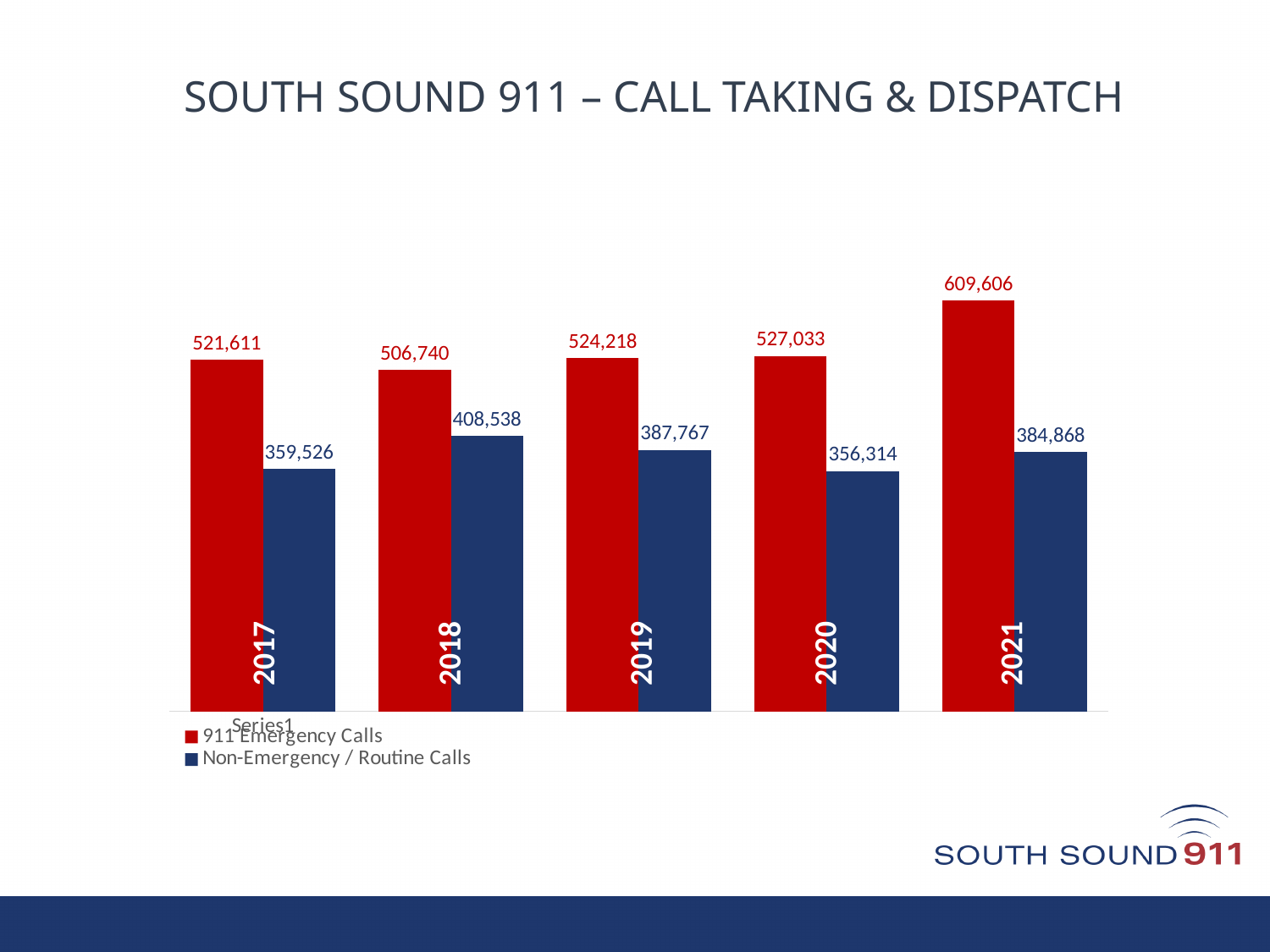
What is the value for 911 Emergency Calls in 2021? 609,606 How many years are shown on the x axis? 5 What is the difference between 911 Emergency Calls in 2021 and in 2017? 87,995 Which is larger: Non-Emergency / Routine Calls in 2019 or in 2021? 2019 Which year has the lowest value for Non-Emergency / Routine Calls? 2020 What is the value for 911 Emergency Calls in 2019? 524,218 What kind of chart is shown on the slide? Bar chart What is the value for Non-Emergency / Routine Calls in 2018? 408,538 How many series does the legend list? 2 What is the value for Non-Emergency / Routine Calls in 2020? 356,314 What is the difference between 911 Emergency Calls and Non-Emergency / Routine Calls in 2017? 162,085 Which year has the highest value for 911 Emergency Calls? 2021